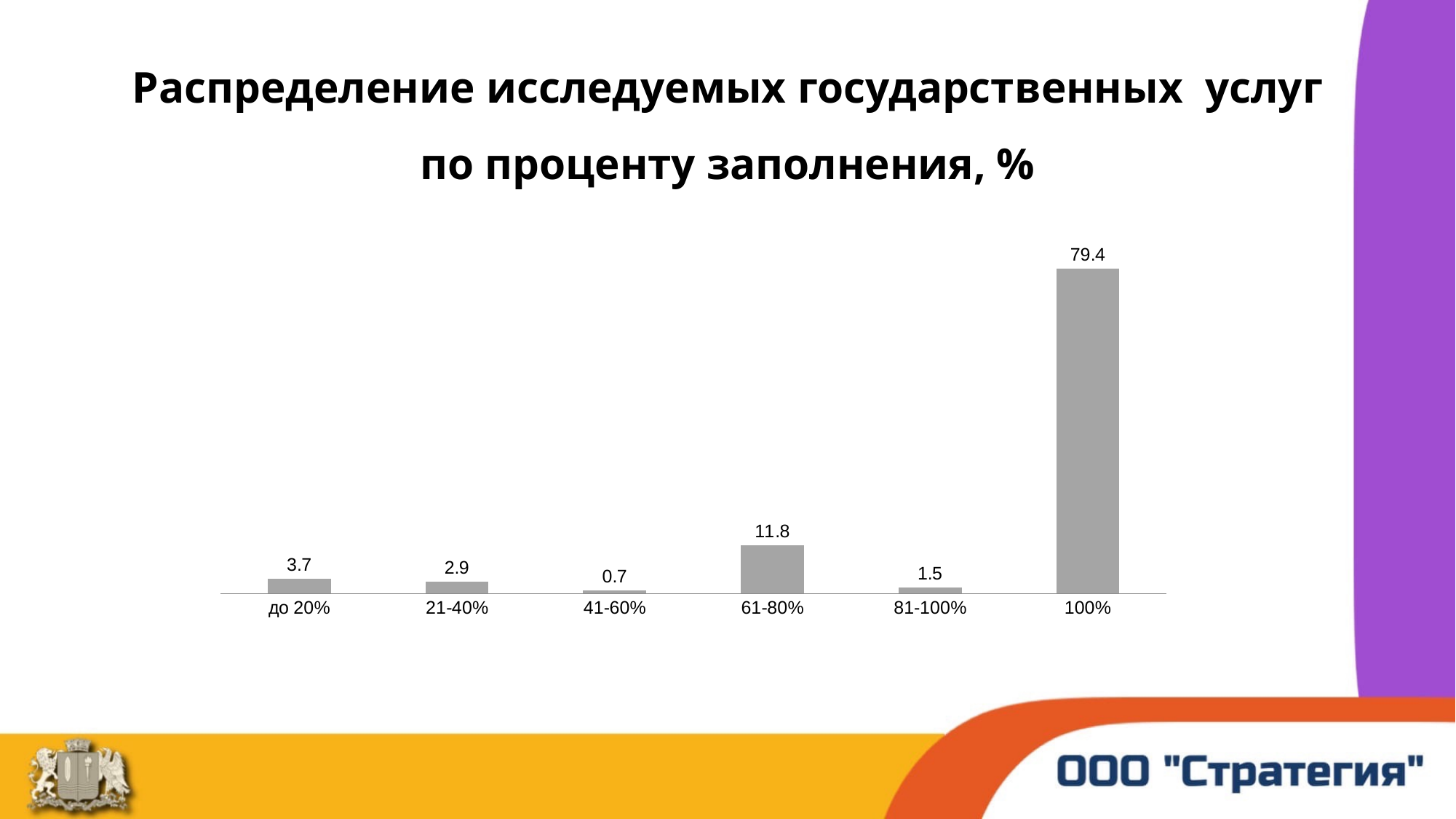
What is the value for the "до 20%" category? 3.7 What kind of chart is shown on the slide? bar chart What is the title of the chart? Распределение исследуемых государственных услуг по проценту заполнения, % Which category has the highest value? 100% What is the difference between the values for "до 20%" and "21-40%"? 0.8 Which is larger, the value for "21-40%" or the value for "81-100%"? 21-40% What is the value for the "61-80%" category? 11.8 How many categories are shown on the x axis? 6 Which category has the lowest value? 41-60% What is the value for the "100%" category? 79.4 What is the value for the "81-100%" category? 1.5 What is the difference between the values for "100%" and "61-80%"? 67.6